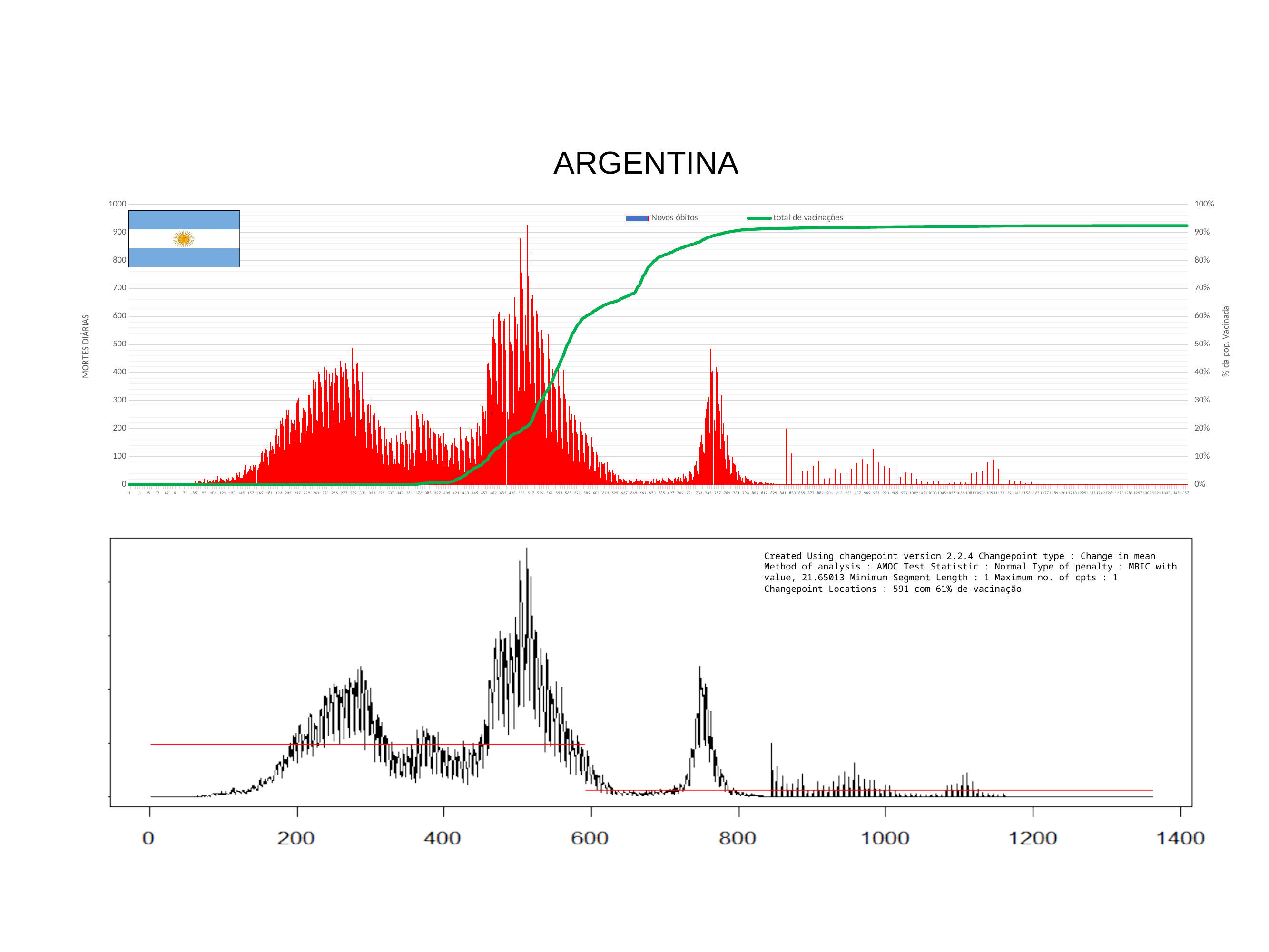
According to the text on the bottom chart, at which location is the changepoint? 591 On the top chart, is the peak of the 'Novos óbitos' bars around day 745 greater or less than 600? less On the bottom chart, what is the largest tick value shown on the x axis? 1400 On the top chart, is the highest value of the red 'Novos óbitos' bars greater or less than 800? greater On the top chart, does the green 'total de vacinações' line rise or fall along the x axis? rise On the top chart, what is the maximum value shown on the right-hand percentage axis? 100% On the top chart, what are the two legend entries? Novos óbitos and total de vacinações According to the text on the bottom chart, what vaccination percentage corresponds to the changepoint? 61% On the top chart, is the final value of the green 'total de vacinações' line greater or less than 80%? greater On the top chart, what is the title of the left vertical axis? MORTES DIÁRIAS According to the text on the bottom chart, what is the maximum number of changepoints (cpts)? 1 On the top chart, how many series does the legend list? 2